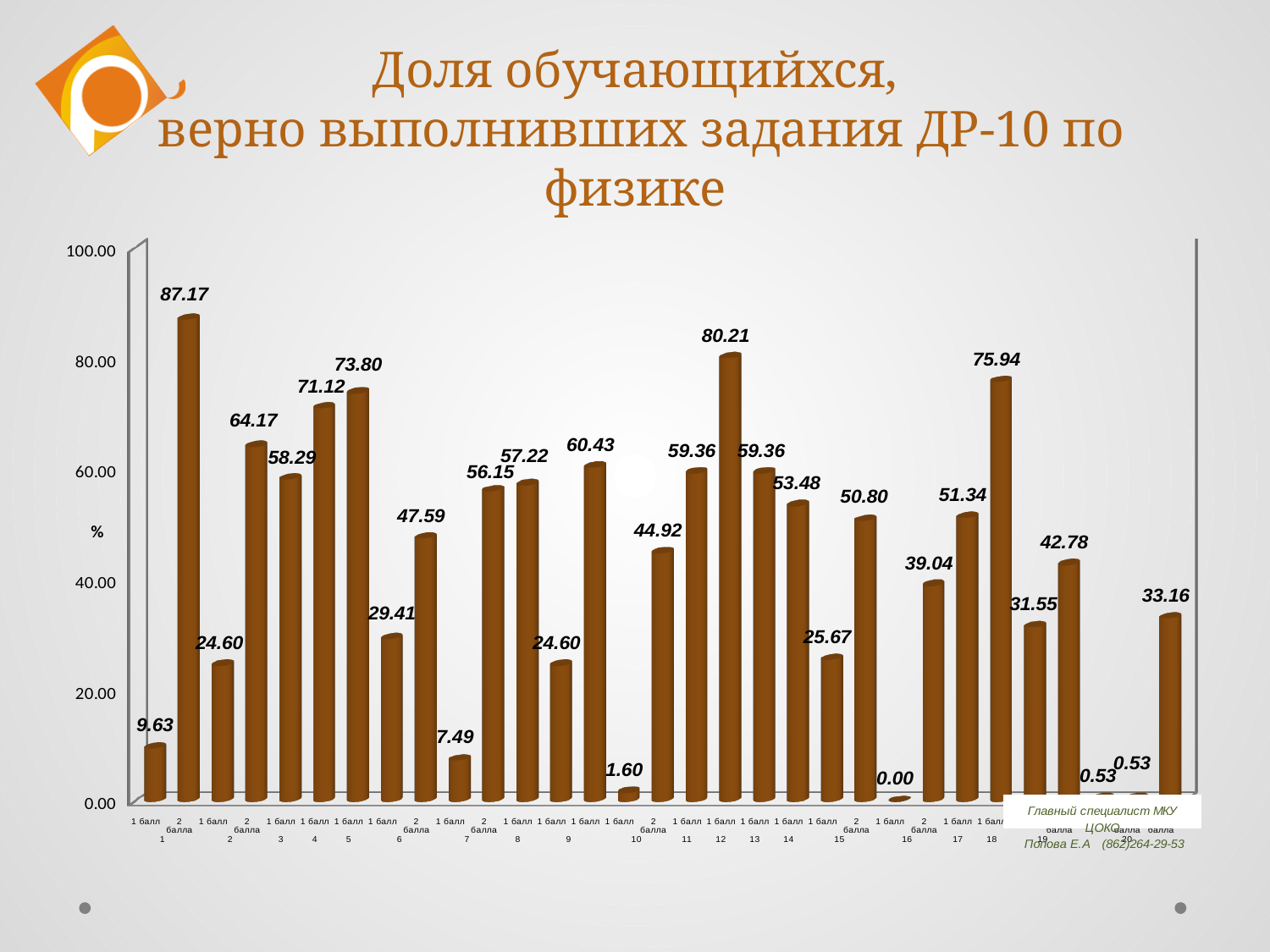
What is the highest value shown in the chart? 87.17 What is the lowest value shown in the chart? 0.00 What unit label is shown on the vertical axis? % What kind of chart is shown on the slide? bar chart What is the difference between the 2 балла and 1 балл values for task 15? 25.13 Which is larger, the value for task 4 (1 балл) or task 5 (1 балл)? task 5 (1 балл) What is the value for task 3 (1 балл)? 58.29 What is the difference between the 2 балла and 1 балл values for task 1? 77.54 What is the value for task 18 (1 балл)? 75.94 What is the value for task 16 (2 балла)? 39.04 What is the value for task 12 (1 балл)? 80.21 What is the value for task 7 (1 балл)? 7.49